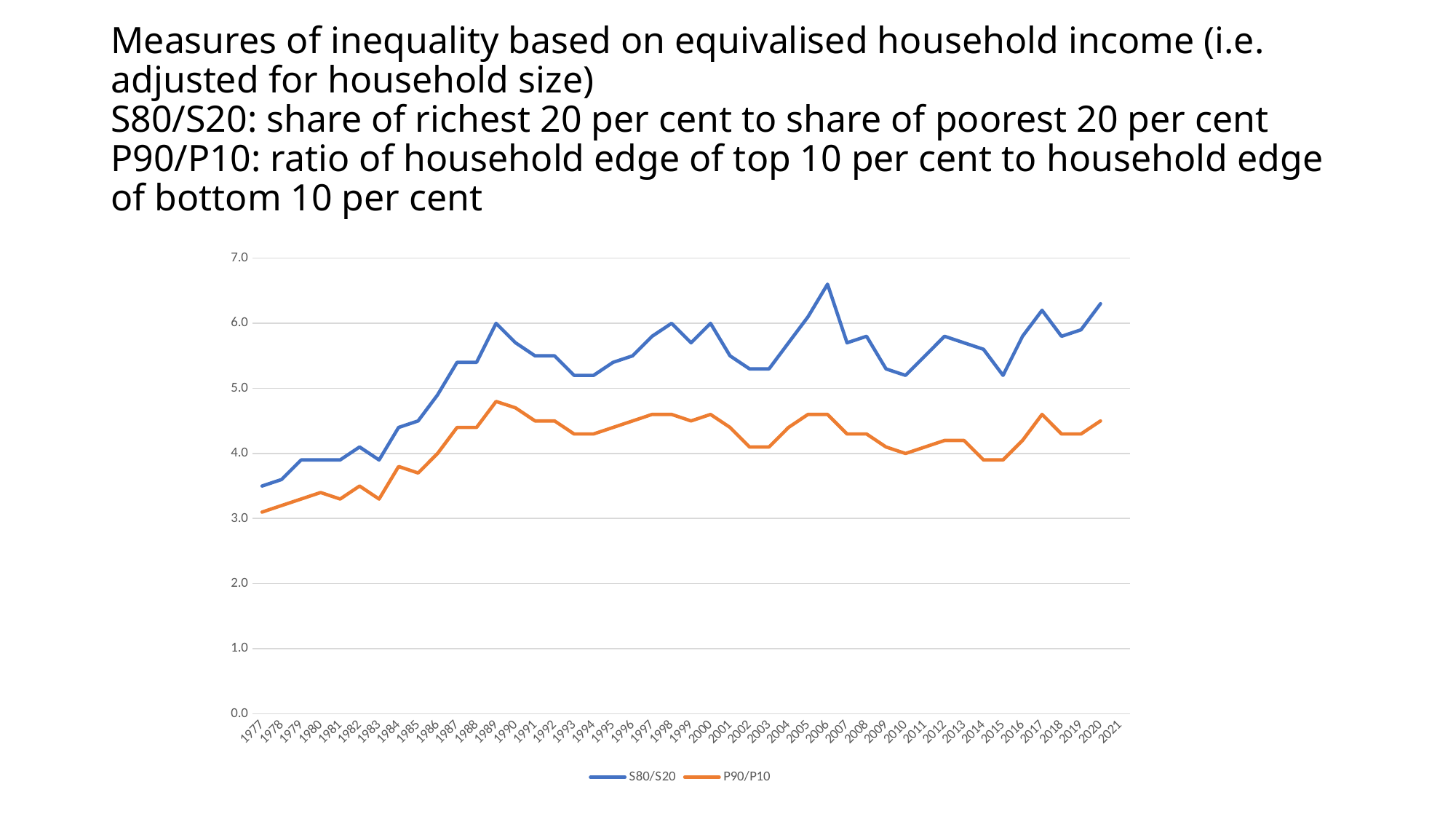
Is the value for S80/S20 in 2006 greater or less than 6.0? greater In which year does the P90/P10 series reach its highest value? 1989 Does the S80/S20 series rise or fall between 1977 and 1989? rise In which year is the S80/S20 series at its lowest value? 1977 What colour is the S80/S20 line? blue Which series has the higher value in 2006, S80/S20 or P90/P10? S80/S20 What kind of chart is shown on the slide? line chart Is the value for P90/P10 in 1977 greater or less than 4.0? less In which year does the S80/S20 series reach its highest value? 2006 Is the value for S80/S20 in 1977 greater or less than 4.0? less How many series does the legend list? 2 What are the two series named in the legend? S80/S20 and P90/P10